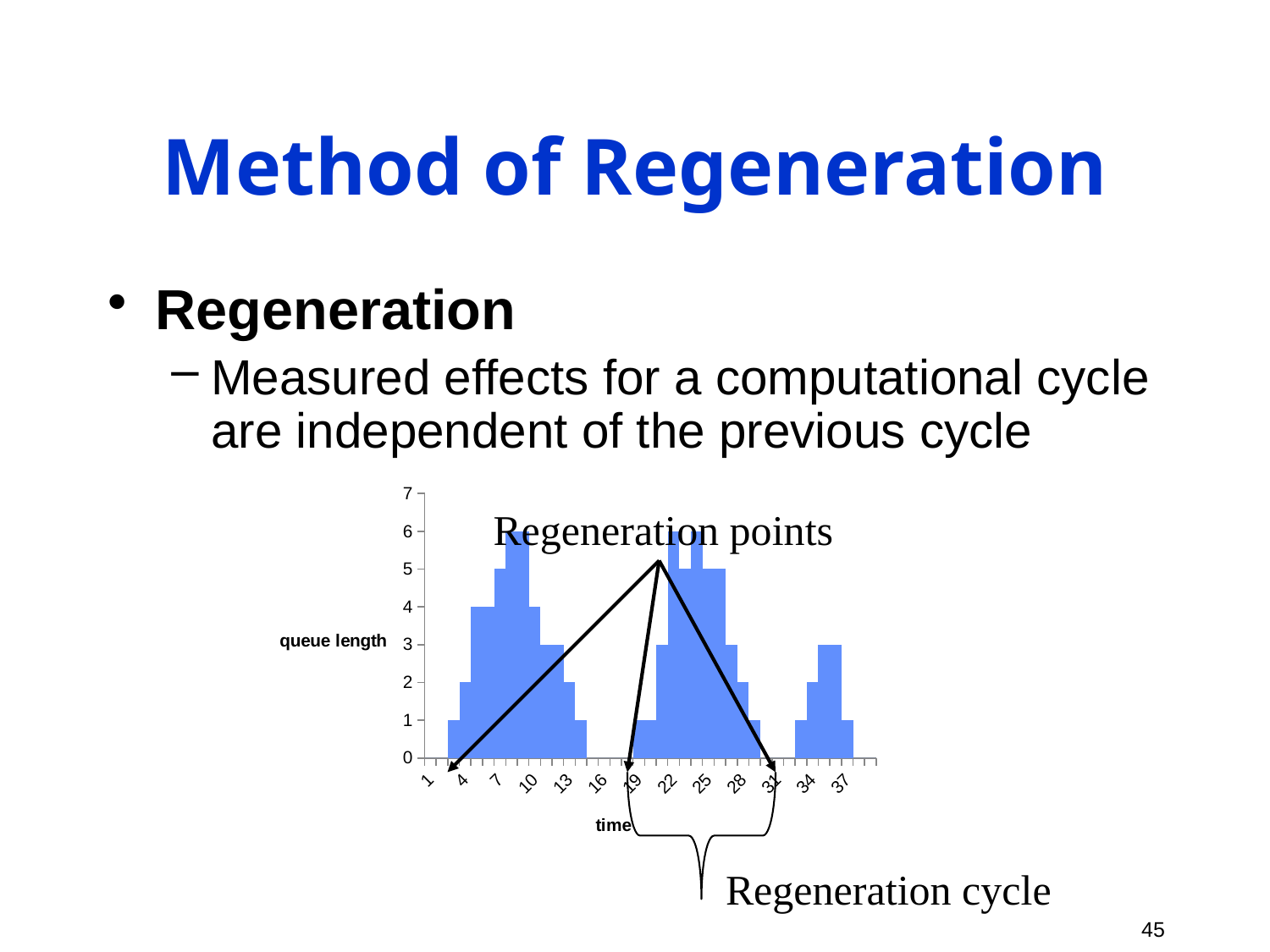
Is the peak queue length of the first cluster of bars (around time 4 to 13) greater or less than 4? greater Which cluster of bars has the lower peak: the first cluster (around time 4 to 13) or the last cluster (around time 34 to 37)? the last cluster What is the first tick label on the horizontal axis? 1 Is the peak queue length of the last cluster of bars (around time 34 to 37) greater or less than 4? less What is the highest queue length reached by any bar in the chart? 6 What is the highest tick value shown on the vertical axis? 7 What is the last tick label on the horizontal axis? 37 Is the peak queue length of the middle cluster of bars (around time 19 to 31) greater or less than 3? greater What kind of chart is shown on the slide? bar chart What is the label on the vertical axis of the chart? queue length What is the label on the horizontal axis of the chart? time How many separate clusters of bars (busy periods) are shown in the chart? 3